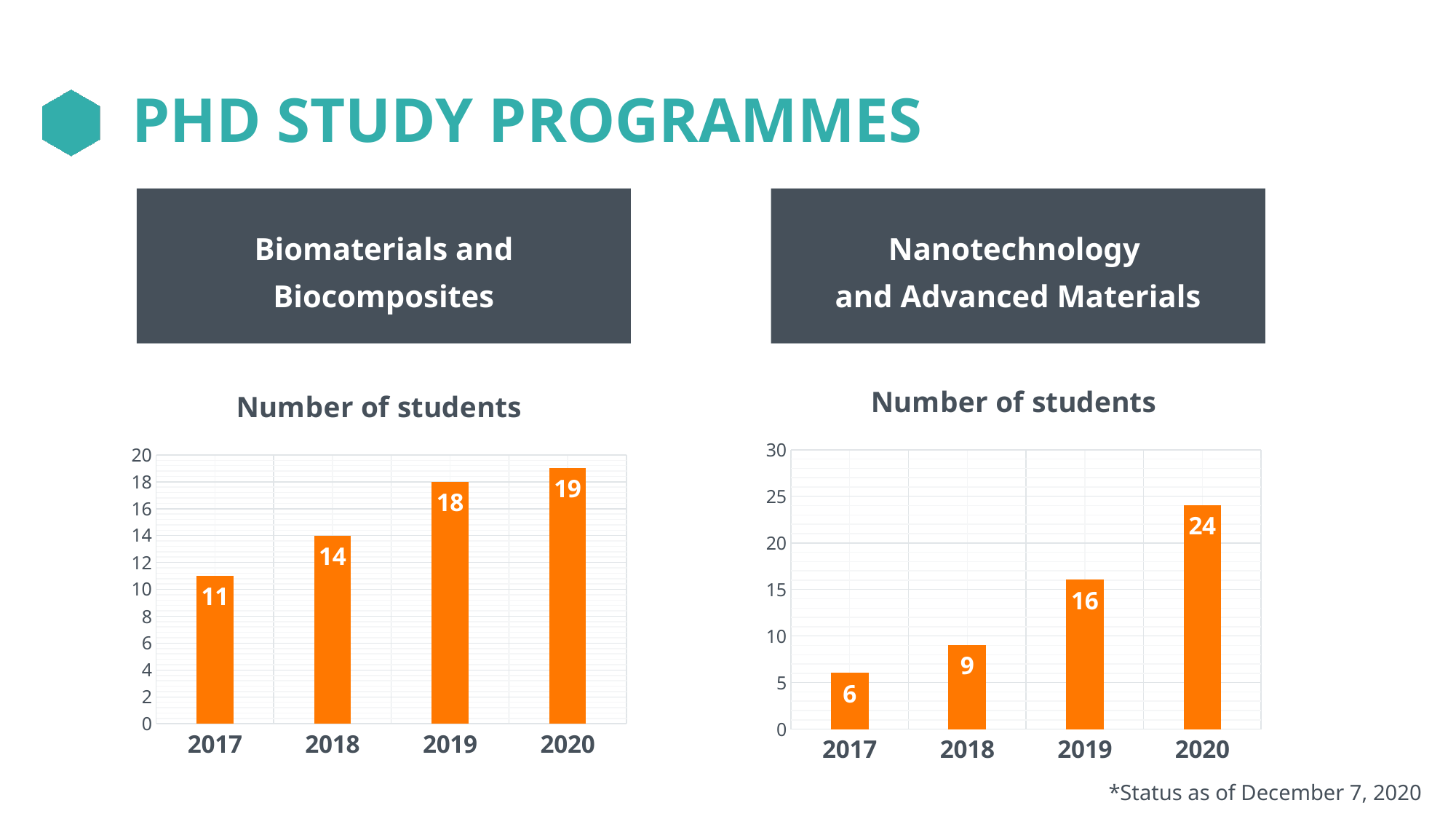
In the Nanotechnology and Advanced Materials chart, what is the number of students in 2020? 24 In the Nanotechnology and Advanced Materials chart, do the values rise or fall from 2017 to 2020? Rise What type of chart is used for the Nanotechnology and Advanced Materials programme? Bar chart In the Nanotechnology and Advanced Materials chart, which year has the lowest number of students? 2017 In the Nanotechnology and Advanced Materials chart, is the value for 2020 greater or less than 20? greater In the Biomaterials and Biocomposites chart, what is the number of students in 2018? 14 In the Biomaterials and Biocomposites chart, what is the difference in the number of students between 2020 and 2017? 8 Which is larger: the number of students in 2019 in the Biomaterials and Biocomposites chart or in 2019 in the Nanotechnology and Advanced Materials chart? Biomaterials and Biocomposites How many years are shown in the Biomaterials and Biocomposites chart? 4 In the Biomaterials and Biocomposites chart, which year has the highest number of students? 2020 In the Nanotechnology and Advanced Materials chart, what is the difference in the number of students between 2019 and 2018? 7 In the Nanotechnology and Advanced Materials chart, what is the number of students in 2017? 6